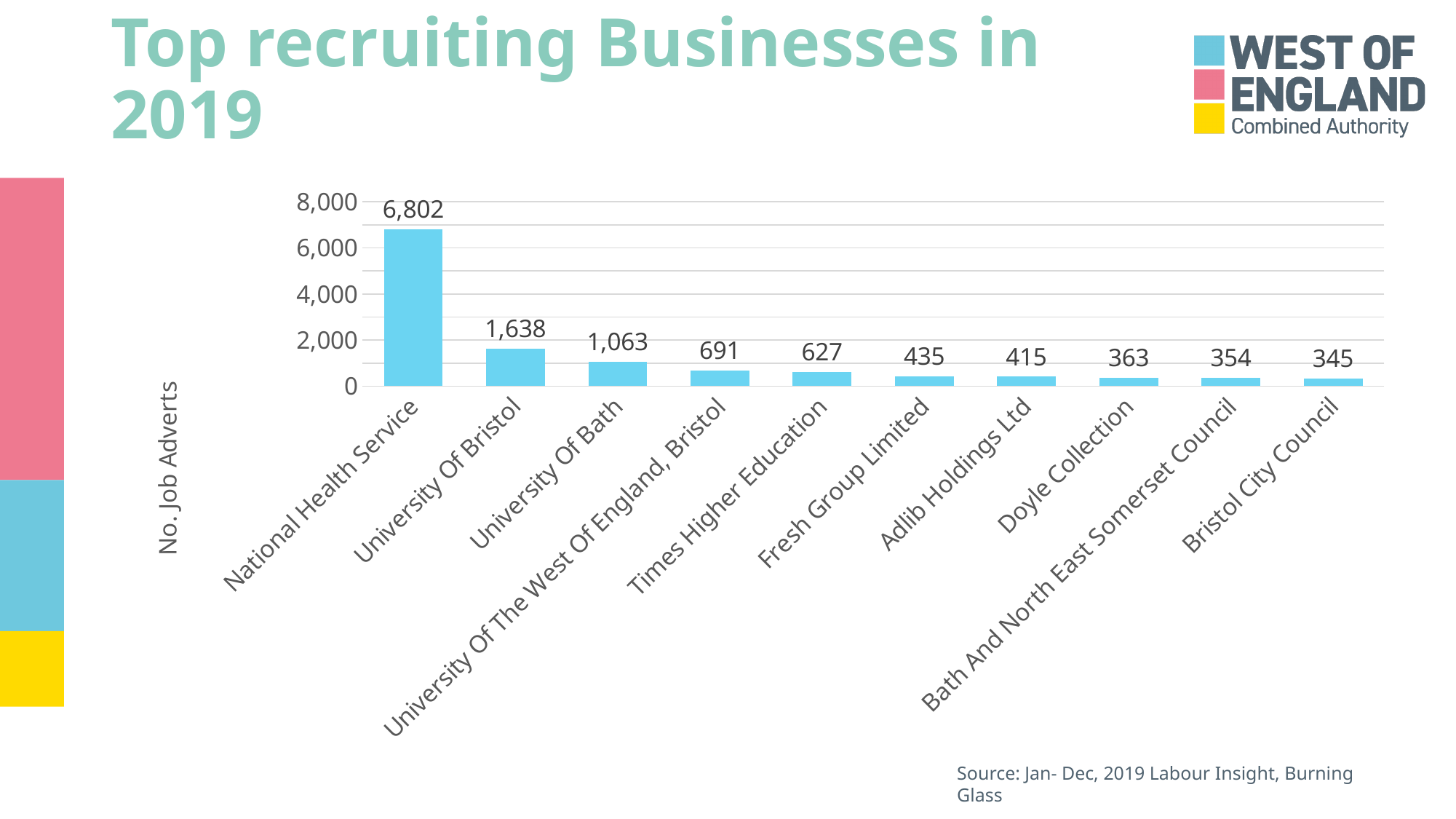
Is the value for University Of Bristol greater or less than 2,000? less What is the number of job adverts for University Of Bath? 1,063 How many job adverts are shown for Bristol City Council? 345 What is the label on the vertical axis of the chart? No. Job Adverts Which business has the highest number of job adverts? National Health Service What is the difference in job adverts between University Of Bristol and University Of Bath? 575 Which has more job adverts, Fresh Group Limited or Adlib Holdings Ltd? Fresh Group Limited Which business has the lowest number of job adverts? Bristol City Council Do the values rise or fall from left to right along the x axis? Fall How many businesses are shown on the chart? 10 What kind of chart is shown on the slide? Bar chart How many job adverts did the National Health Service post in 2019? 6,802